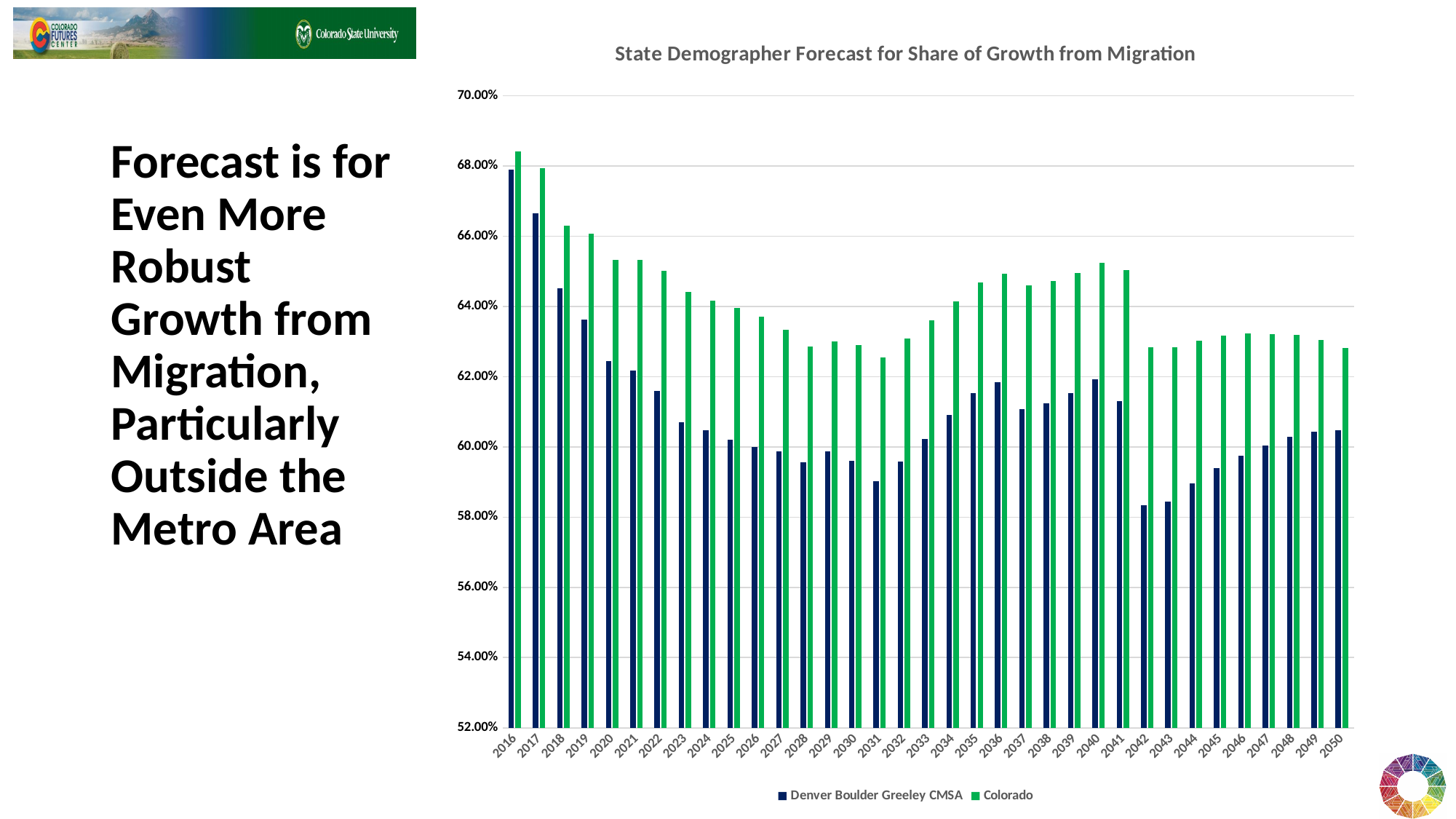
What is the title of the chart? State Demographer Forecast for Share of Growth from Migration How many series does the legend list? 2 Which two series are listed in the chart legend? Denver Boulder Greeley CMSA and Colorado Do the Denver Boulder Greeley CMSA values generally rise or fall from 2016 to 2031? Fall What kind of chart is shown on the slide? Bar chart Is the value for Denver Boulder Greeley CMSA in 2016 greater or less than 66.00%? greater In which year is the Denver Boulder Greeley CMSA value highest? 2016 Is the value for Denver Boulder Greeley CMSA in 2042 greater or less than 60.00%? less Is the value for Colorado in 2031 greater or less than 64.00%? less In which year is the Colorado value highest? 2016 In 2016, which series has the larger value, Denver Boulder Greeley CMSA or Colorado? Colorado How many years are shown along the x axis of the chart? 35